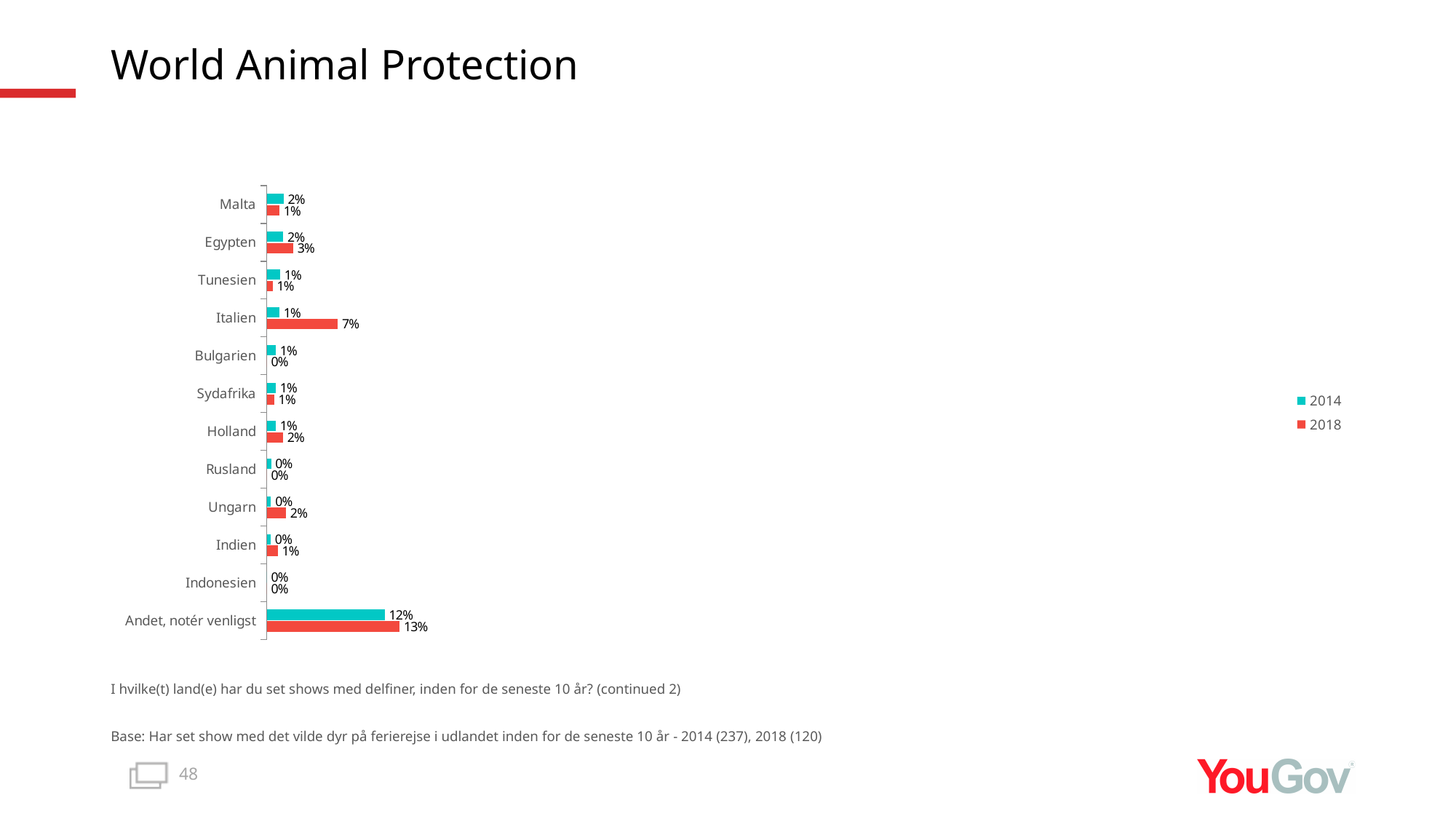
What is the 2014 value for Malta? 2% How many series does the legend list? 2 Which is larger for Ungarn: the 2014 value or the 2018 value? 2018 What kind of chart is shown on the slide? Bar chart What is the 2018 value for Italien? 7% What is the 2014 value for Andet, notér venligst? 12% Which colour represents the 2018 series in the legend? Red What is the difference between the 2018 and 2014 values for Italien? 6% Which category has the highest 2018 value? Andet, notér venligst What is the 2018 value for Egypten? 3% Among the named countries (excluding Andet, notér venligst), which has the highest 2018 value? Italien How many categories are shown on the chart? 12